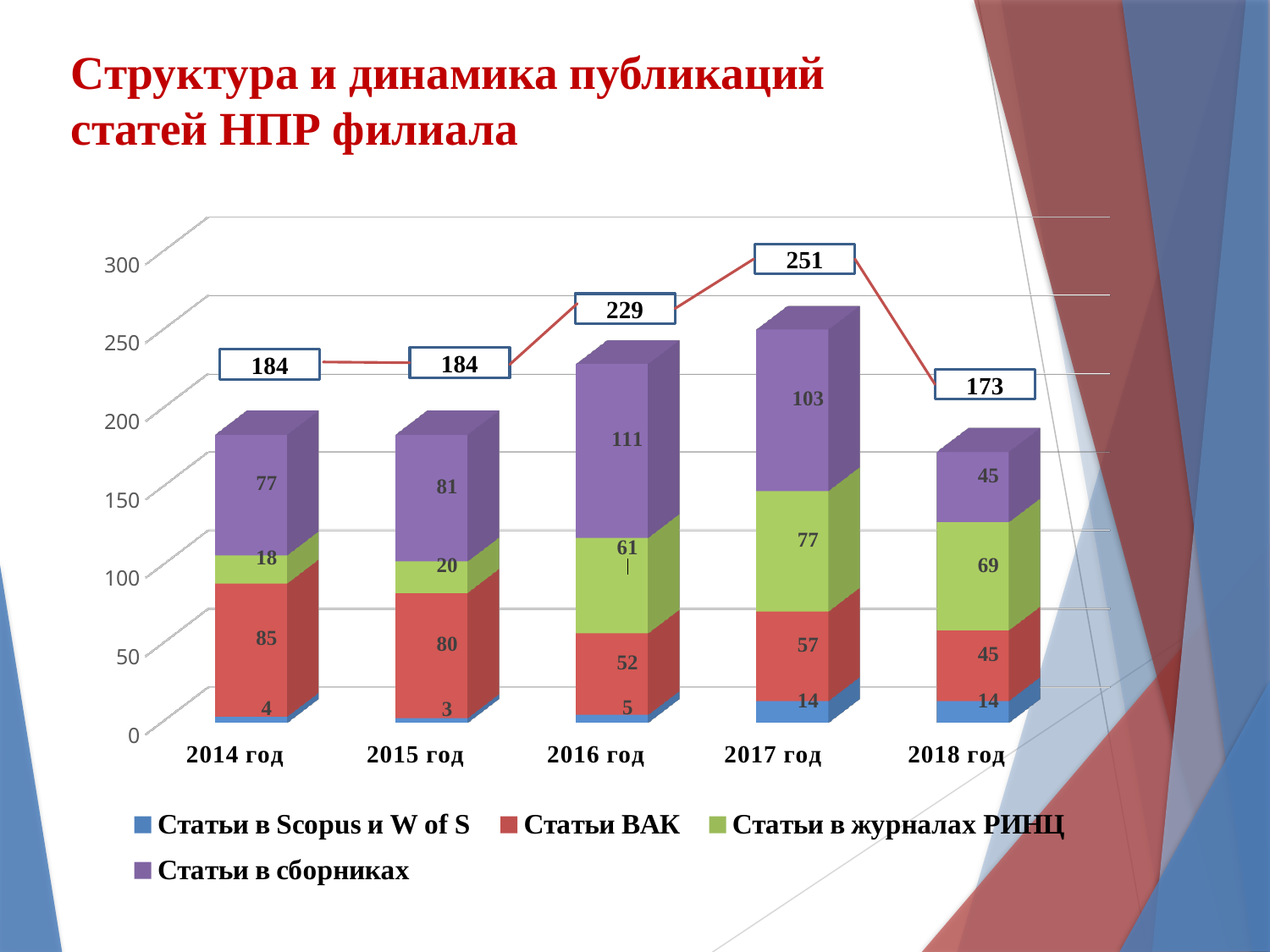
What is the value for Статьи в журналах РИНЦ in 2017 год? 77 Which year has the highest total shown on the line? 2017 год Which is larger: Статьи ВАК in 2016 год or Статьи ВАК in 2017 год? Статьи ВАК in 2017 год What is the value for Статьи ВАК in 2014 год? 85 What is the difference between the totals for 2017 год and 2016 год? 22 What is the value for Статьи в Scopus и W of S in 2015 год? 3 What kind of chart is shown on the slide? Stacked bar chart with a line What is the value for Статьи в сборниках in 2016 год? 111 Which year has the lowest total shown on the line? 2018 год How many years are shown on the x axis? 5 What is the total for the stacked bar for 2018 год? 173 How many series does the legend list? 4